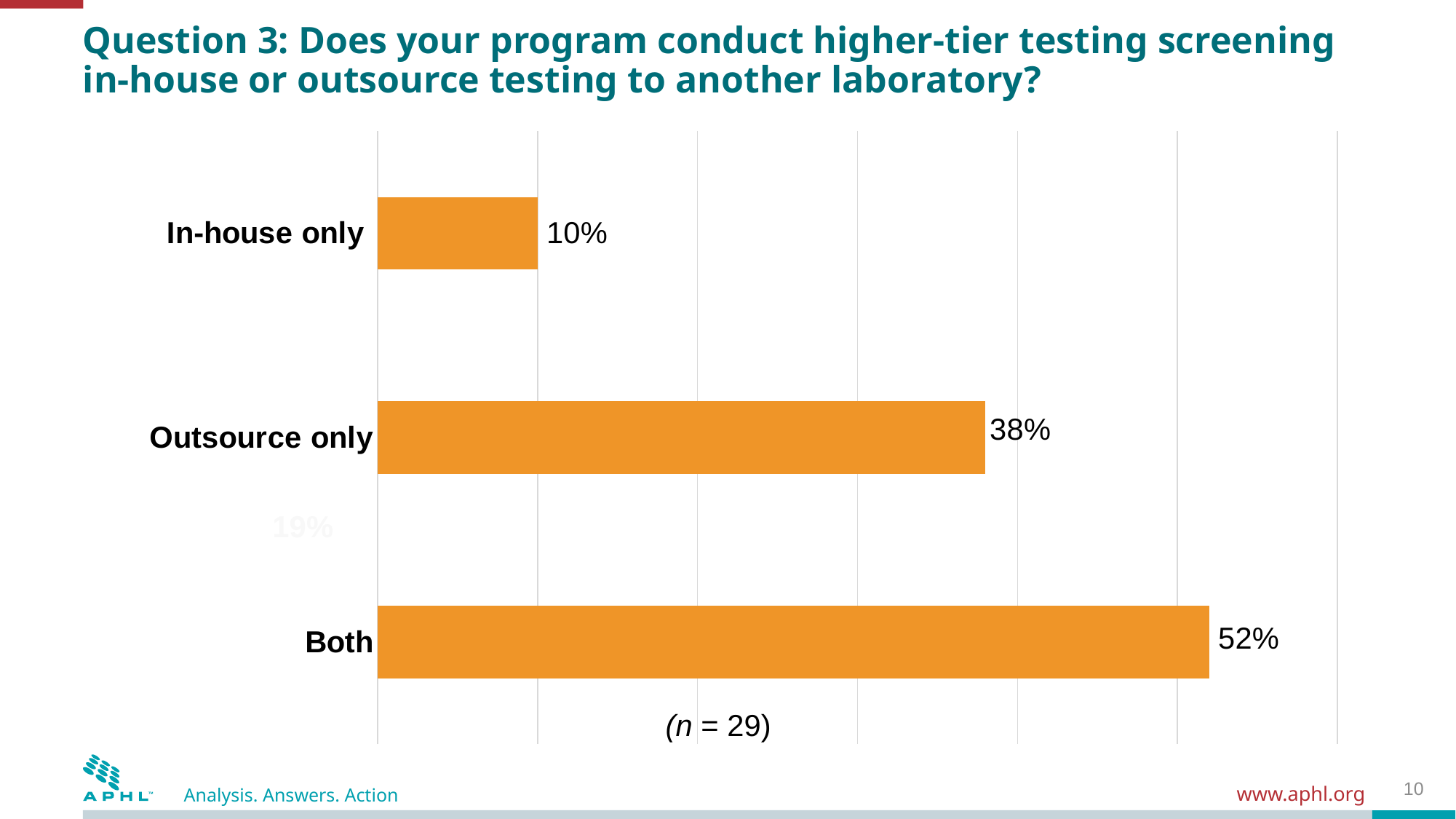
Which category has the lowest percentage? In-house only What percentage of programs answered 'Both'? 52% What is the difference in percentage points between 'Both' and 'Outsource only'? 14 What kind of chart is shown on the slide? Bar chart What is the difference in percentage points between 'Outsource only' and 'In-house only'? 28 What percentage of programs outsource higher-tier testing only? 38% What is the sample size (n) noted below the chart? 29 Which category has the highest percentage? Both How many categories are shown in the chart? 3 What percentage of programs conduct higher-tier testing in-house only? 10% Which is larger, the value for 'Outsource only' or the value for 'In-house only'? Outsource only What colour are the bars in the chart? Orange